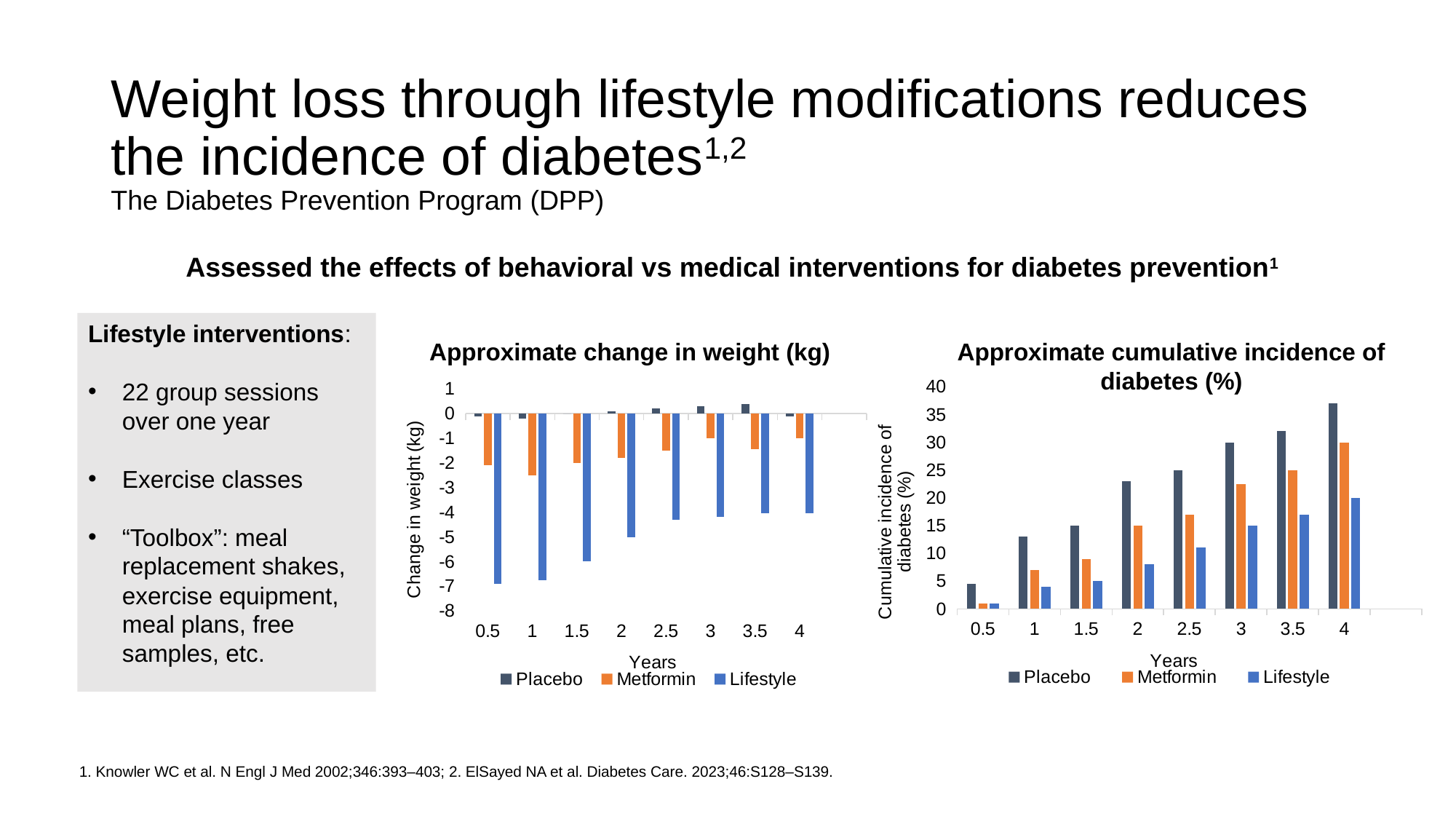
In the 'Approximate cumulative incidence of diabetes (%)' chart, is the value for Placebo at 4 years greater or less than 35? greater In the 'Approximate cumulative incidence of diabetes (%)' chart, do the Placebo values rise or fall as years increase? rise In the 'Approximate cumulative incidence of diabetes (%)' chart, what is the value for Lifestyle at 4 years? 20 In the 'Approximate cumulative incidence of diabetes (%)' chart, what is the value for Metformin at 4 years? 30 In the 'Approximate change in weight (kg)' chart, which series shows the larger weight loss at 1 year, Metformin or Lifestyle? Lifestyle In the 'Approximate cumulative incidence of diabetes (%)' chart, what is the difference between Placebo and Lifestyle at 3 years? 15 In the 'Approximate cumulative incidence of diabetes (%)' chart, which series has the highest bar at 4 years? Placebo In the 'Approximate change in weight (kg)' chart, is the value for Lifestyle at 0.5 years greater or less than -6? less How many time points (years) are shown on the x axis of the 'Approximate change in weight (kg)' chart? 8 How many series does the legend of the 'Approximate cumulative incidence of diabetes (%)' chart list? 3 In the 'Approximate cumulative incidence of diabetes (%)' chart, what is the value for Placebo at 3 years? 30 What kind of chart is the 'Approximate change in weight (kg)' chart? bar chart